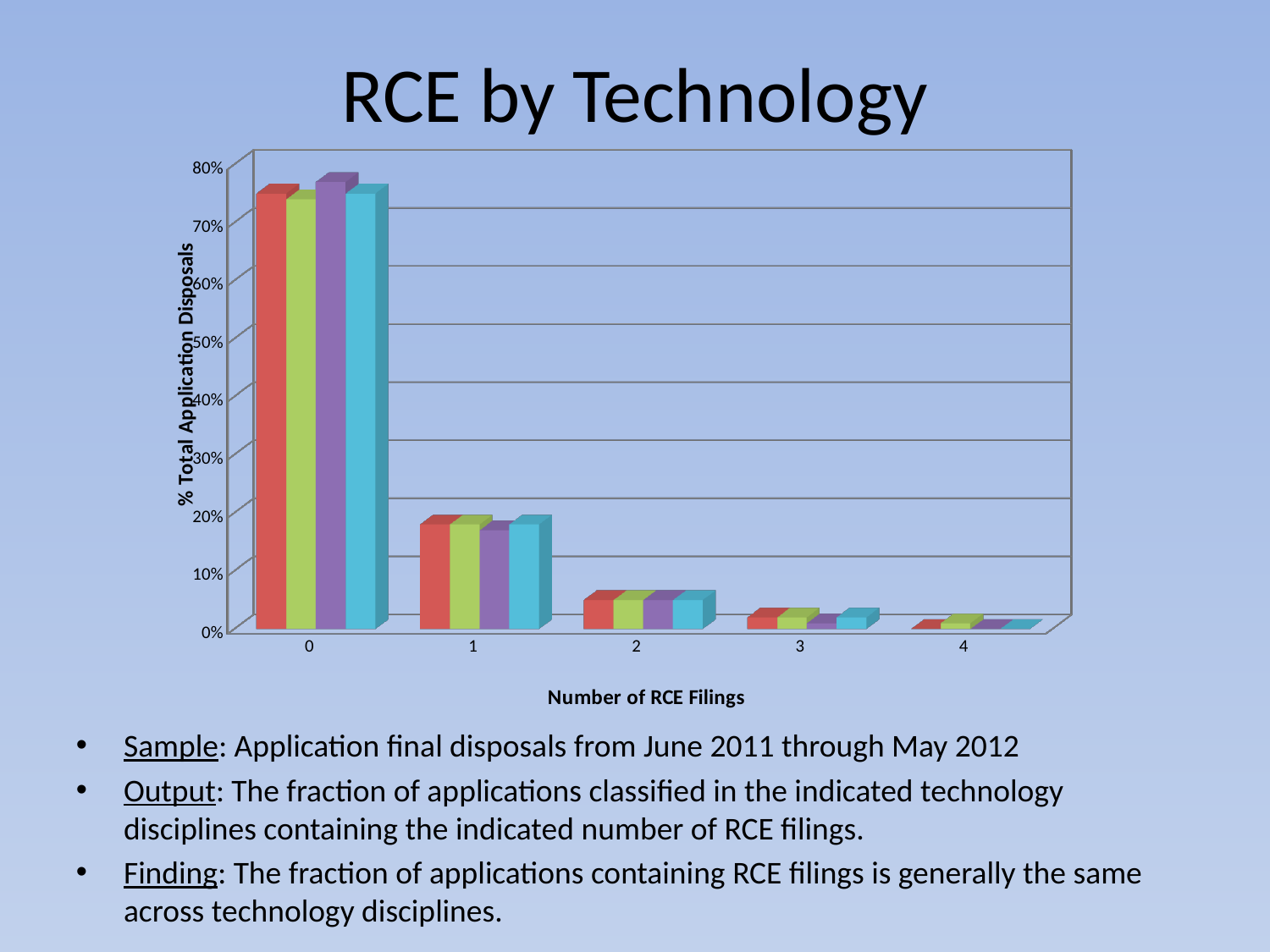
What is the title of the chart? RCE by Technology Is the value of the red bar for 1 RCE filing greater or less than 20%? less What kind of chart is shown on the slide? bar chart Which has larger values, 0 RCE filings or 1 RCE filing? 0 Is the value of the red bar for 0 RCE filings greater or less than 70%? greater What is the label of the x axis? Number of RCE Filings Which number of RCE filings has the lowest bars? 4 Is the value of the red bar for 2 RCE filings greater or less than 10%? less How many bars are plotted for each category on the x axis? 4 Which number of RCE filings has the highest bars? 0 Do the values rise or fall as the number of RCE filings increases along the x axis? fall How many categories are shown on the x axis? 5